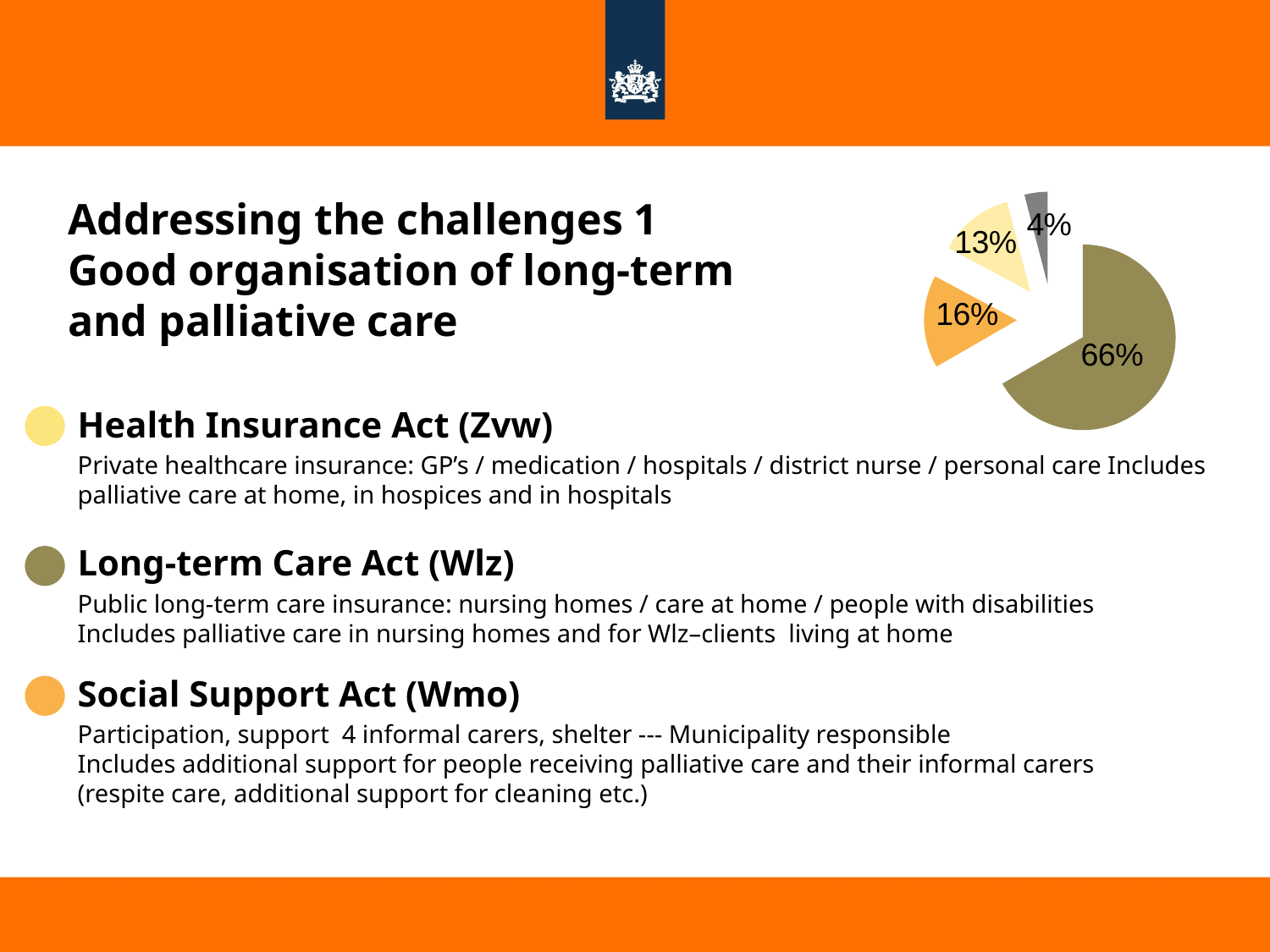
What is the difference in percentage points between the 66% slice and the 16% slice? 50 percentage points Which slice is larger, the orange slice or the light yellow slice? The orange slice (16%) What percentage is labelled on the light yellow slice of the pie chart? 13% What colour is the largest slice of the pie chart? Olive What is the largest percentage shown on the pie chart? 66% What is the difference in percentage points between the orange slice and the light yellow slice? 3 percentage points What kind of chart is shown on the slide? Pie chart What percentage is labelled on the olive-coloured slice of the pie chart? 66% How many slices does the pie chart have? 4 What percentage is labelled on the grey slice of the pie chart? 4% What percentage is labelled on the orange slice of the pie chart? 16% What is the smallest percentage shown on the pie chart? 4%